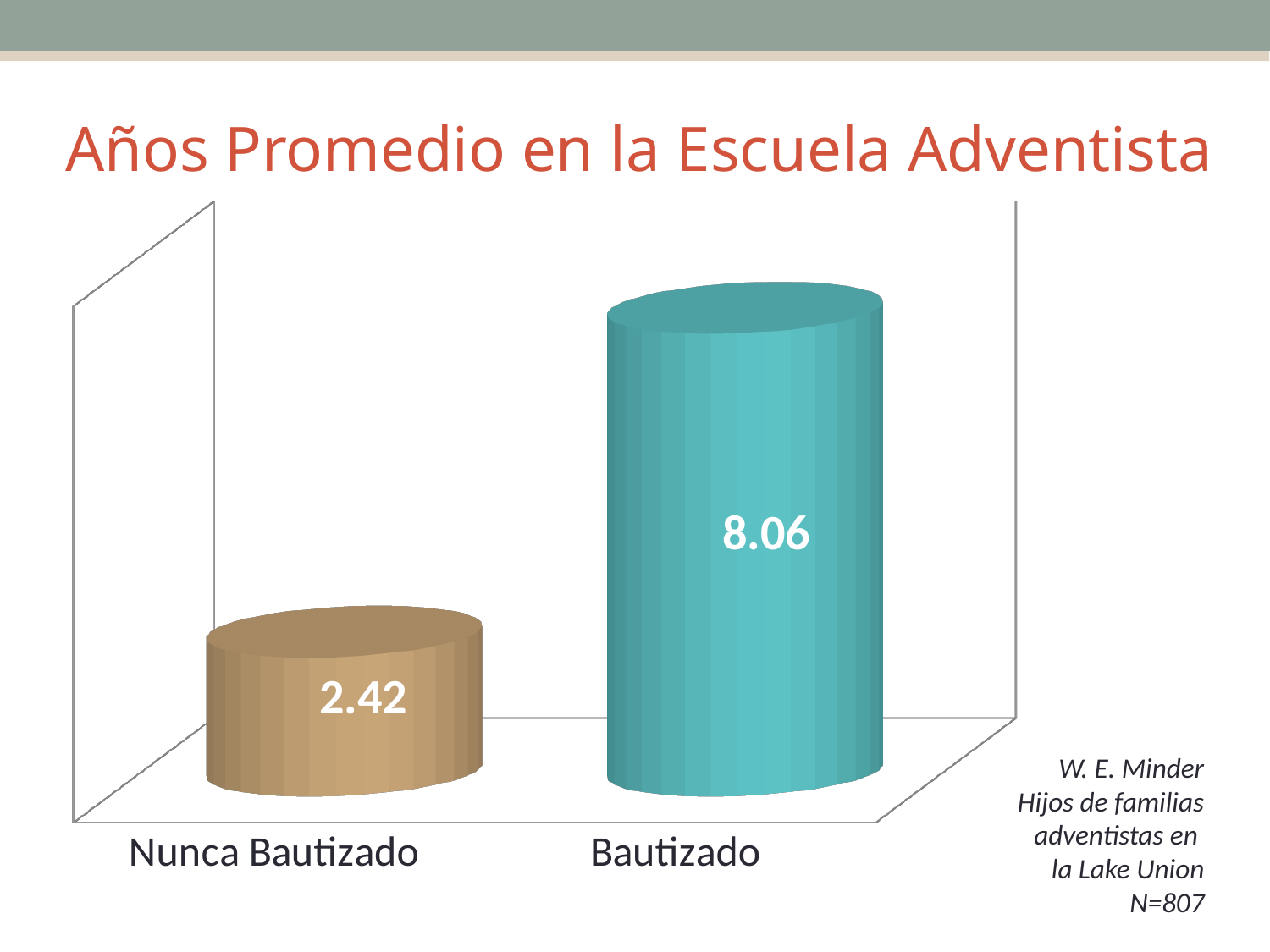
How many categories are shown in the chart? 2 Which category has the highest value? Bautizado What colour is the bar for Bautizado? Teal Which category has the lowest value? Nunca Bautizado What is the title of the chart? Años Promedio en la Escuela Adventista What is the value for Nunca Bautizado? 2.42 What is the value for Bautizado? 8.06 Which is larger, the value for Bautizado or the value for Nunca Bautizado? Bautizado What kind of chart is shown on the slide? Bar chart What is the sample size (N) noted on the slide? N=807 What is the difference between the values for Bautizado and Nunca Bautizado? 5.64